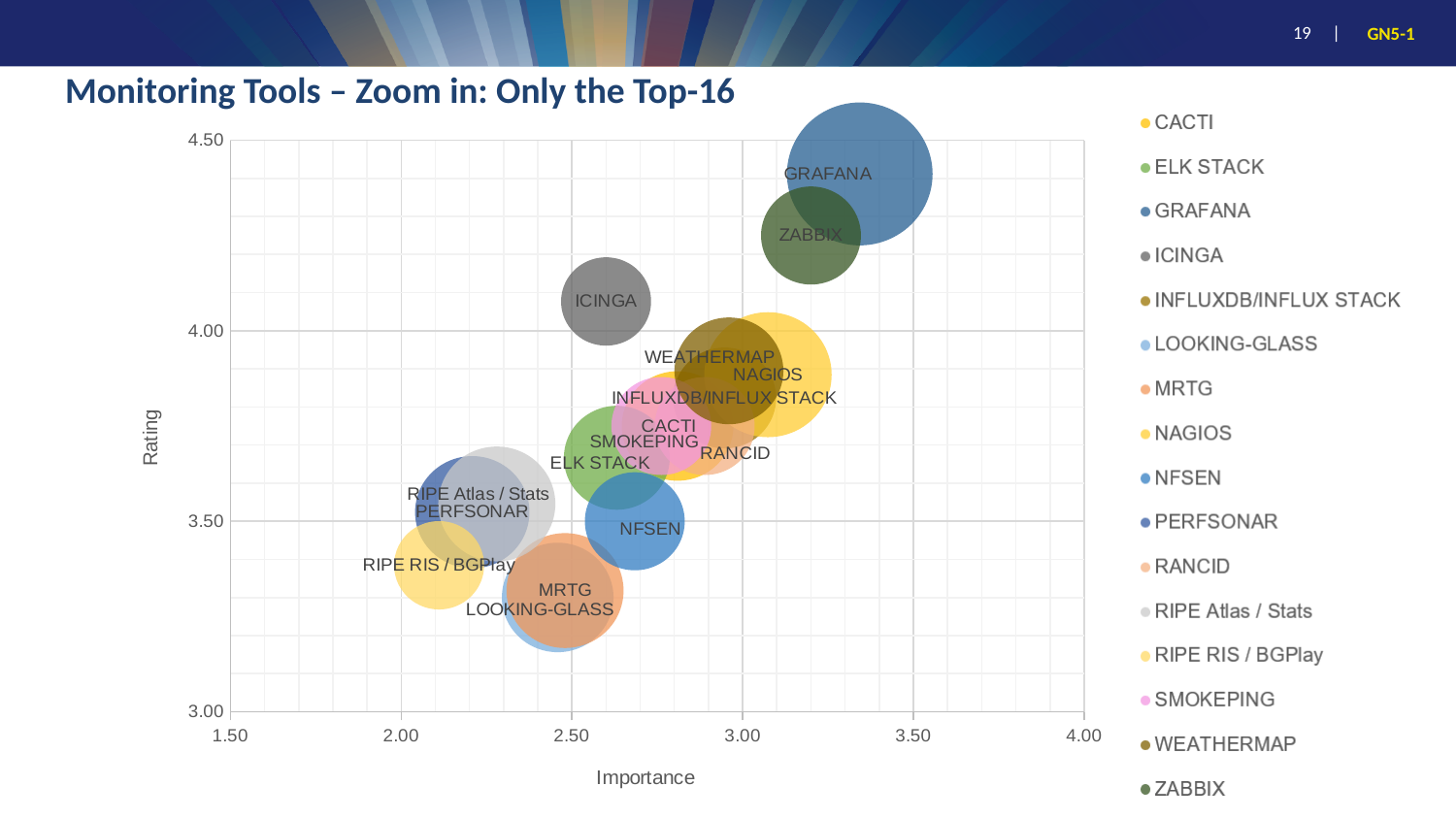
Is the Importance for ZABBIX greater or less than 3.00? greater Which has the higher Importance, ZABBIX or MRTG? ZABBIX What is the label of the vertical axis? Rating Which tool has the lowest Importance? RIPE RIS / BGPlay Which tool has the highest Rating? GRAFANA What kind of chart is shown on the slide? bubble chart Which has the higher Rating, GRAFANA or ICINGA? GRAFANA Is the Rating for GRAFANA greater or less than 4.00? greater Which tool has the highest Importance? GRAFANA What is the title of the chart? Monitoring Tools – Zoom in: Only the Top-16 Is the Rating for MRTG greater or less than 3.50? less How many series does the legend list? 16